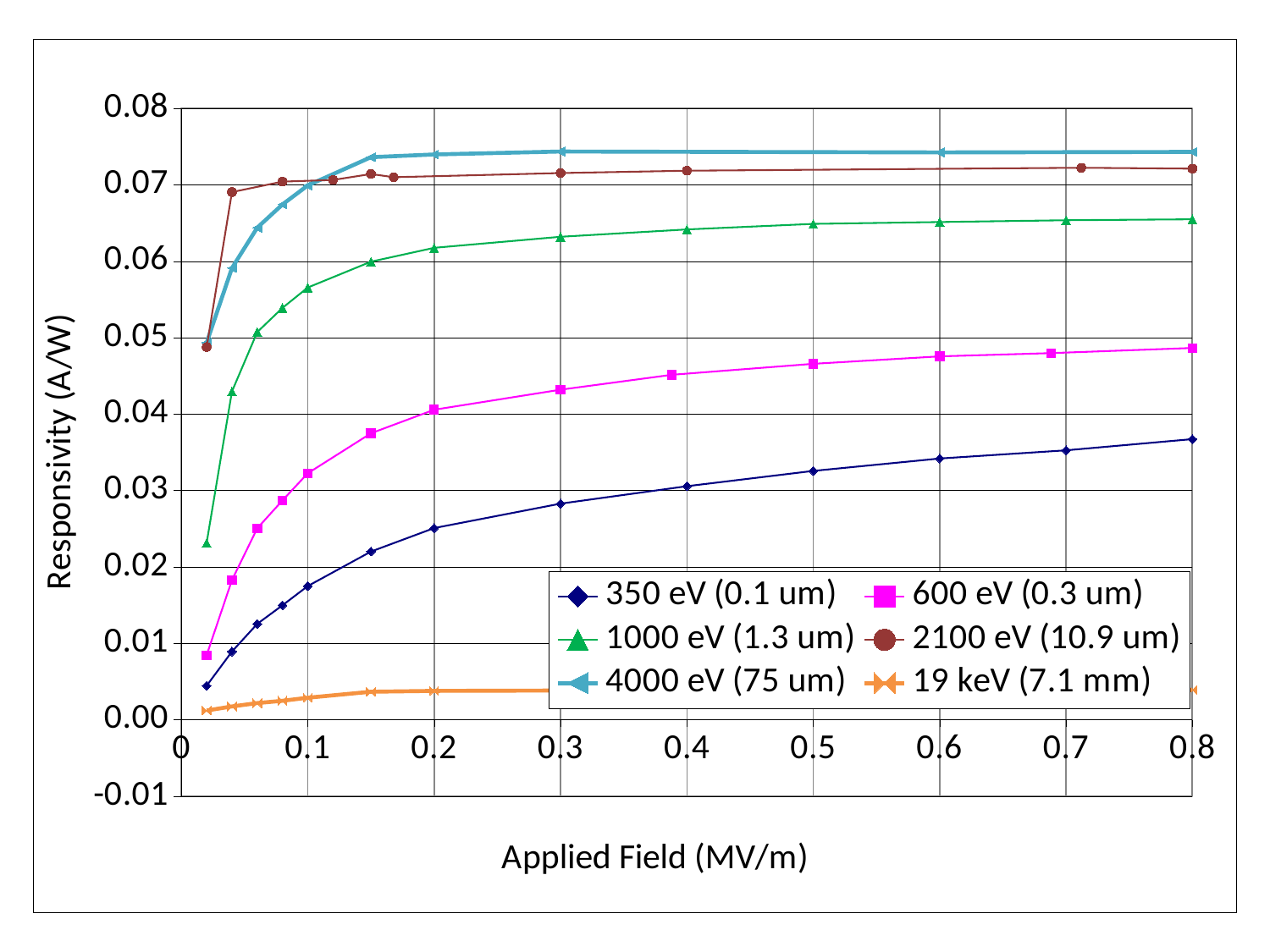
Is the responsivity for the 600 eV (0.3 um) series at 0.8 MV/m greater or less than 0.04? greater How many series does the legend list? 6 At 0.04 MV/m, which series has the higher responsivity: 2100 eV (10.9 um) or 4000 eV (75 um)? 2100 eV (10.9 um) Does the responsivity for the 350 eV (0.1 um) series rise or fall as the applied field increases? rise What is the title of the x axis? Applied Field (MV/m) Is the responsivity for the 1000 eV (1.3 um) series at 0.8 MV/m greater or less than 0.06? greater At 0.2 MV/m, which series has the higher responsivity: 1000 eV (1.3 um) or 600 eV (0.3 um)? 1000 eV (1.3 um) What kind of chart is shown on the slide? line chart Is the responsivity for the 4000 eV (75 um) series at 0.3 MV/m greater or less than 0.07? greater Which series has the lowest responsivity across the whole range of applied field? 19 keV (7.1 mm) What is the title of the y axis? Responsivity (A/W)